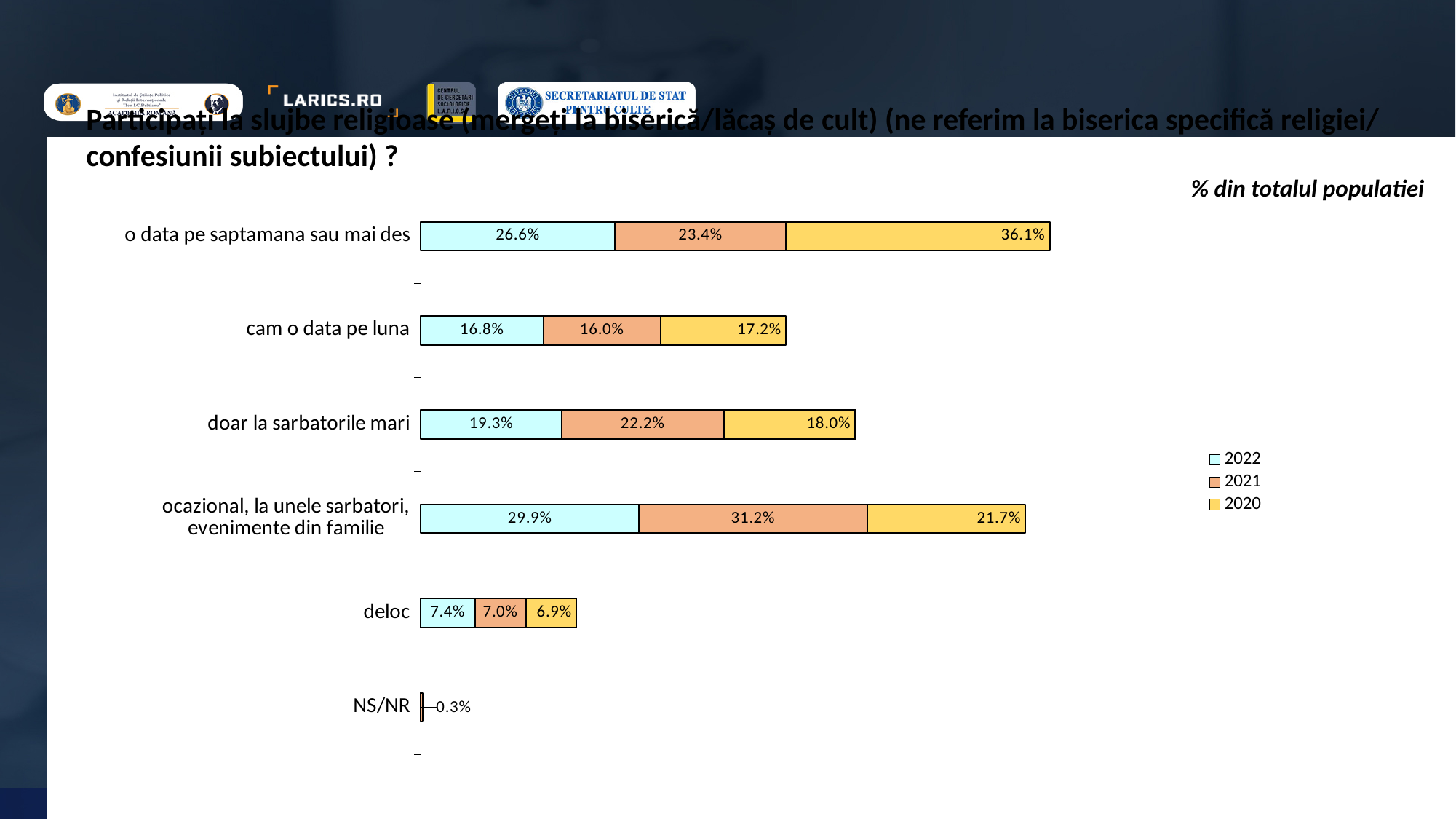
What kind of chart is shown on the slide? stacked bar chart What is the 2021 value for "doar la sarbatorile mari"? 22.2% What is the 2022 value for "deloc"? 7.4% How many categories are shown on the vertical axis of the chart? 6 What is the total of the stacked bar for "deloc"? 21.3% Which category has the highest 2020 value? o data pe saptamana sau mai des What is the 2022 value for "ocazional, la unele sarbatori, evenimente din familie"? 29.9% What is the difference between the 2020 and 2022 values for "o data pe saptamana sau mai des"? 9.5% What is the 2020 value for "o data pe saptamana sau mai des"? 36.1% How many series does the legend list? 3 Which is larger for "cam o data pe luna": the 2022 value or the 2021 value? 2022 Which category has the lowest 2022 value? NS/NR